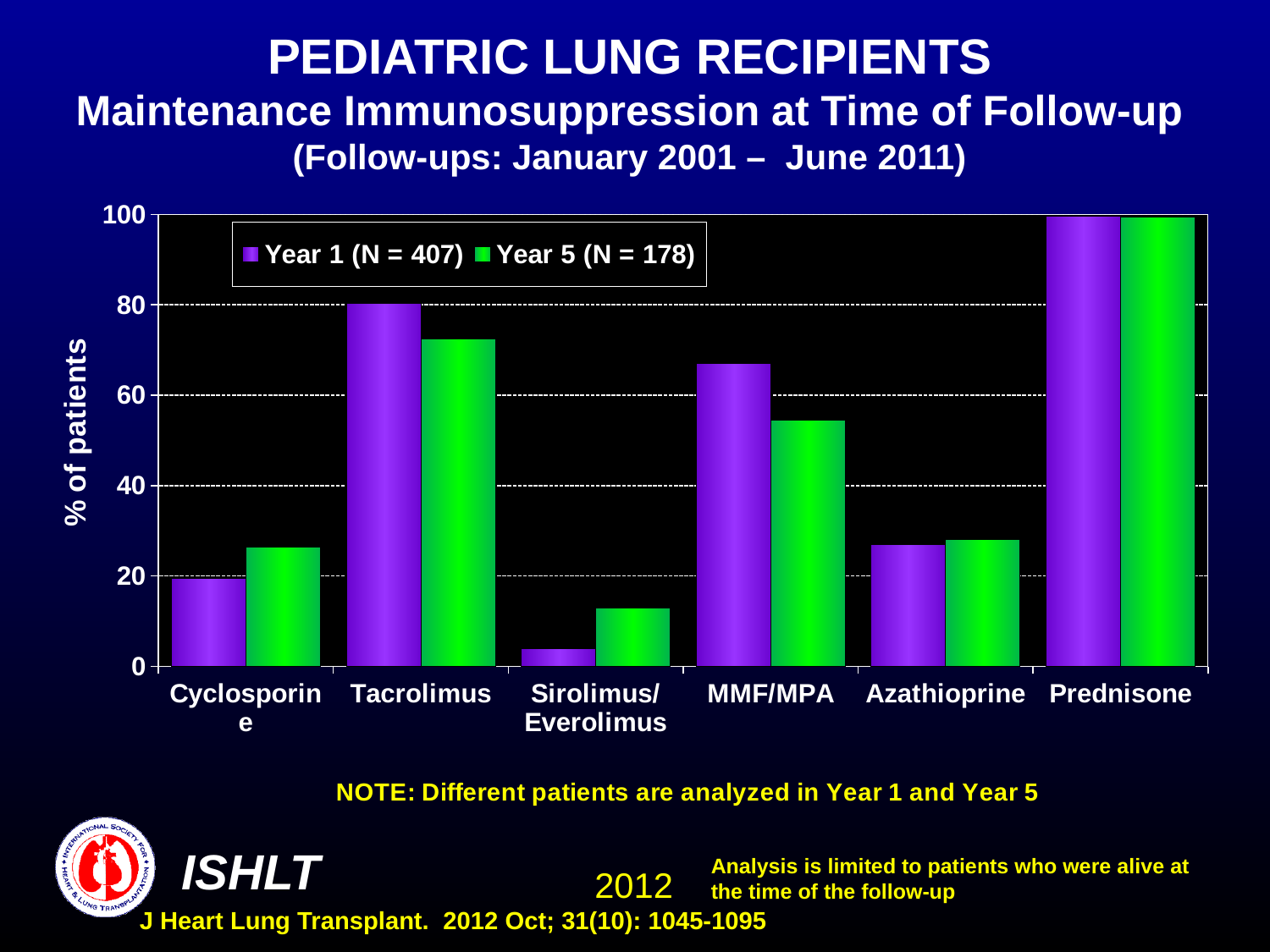
Is the Year 1 (N = 407) value for Sirolimus/Everolimus greater or less than 20? less What kind of chart is shown on the slide? Bar chart For Tacrolimus, which is larger: the Year 1 (N = 407) value or the Year 5 (N = 178) value? Year 1 (N = 407) Is the Year 5 (N = 178) value for MMF/MPA greater or less than 60? less For Cyclosporine, which is larger: the Year 1 (N = 407) value or the Year 5 (N = 178) value? Year 5 (N = 178) Which category has the lowest Year 5 (N = 178) value? Sirolimus/Everolimus Is the Year 5 (N = 178) value for Tacrolimus greater or less than 60? greater Which category has the lowest Year 1 (N = 407) value? Sirolimus/Everolimus How many series does the legend list? 2 Which category has the highest Year 1 (N = 407) value? Prednisone How many drug categories are shown on the x axis? 6 What is the label on the y axis of the chart? % of patients